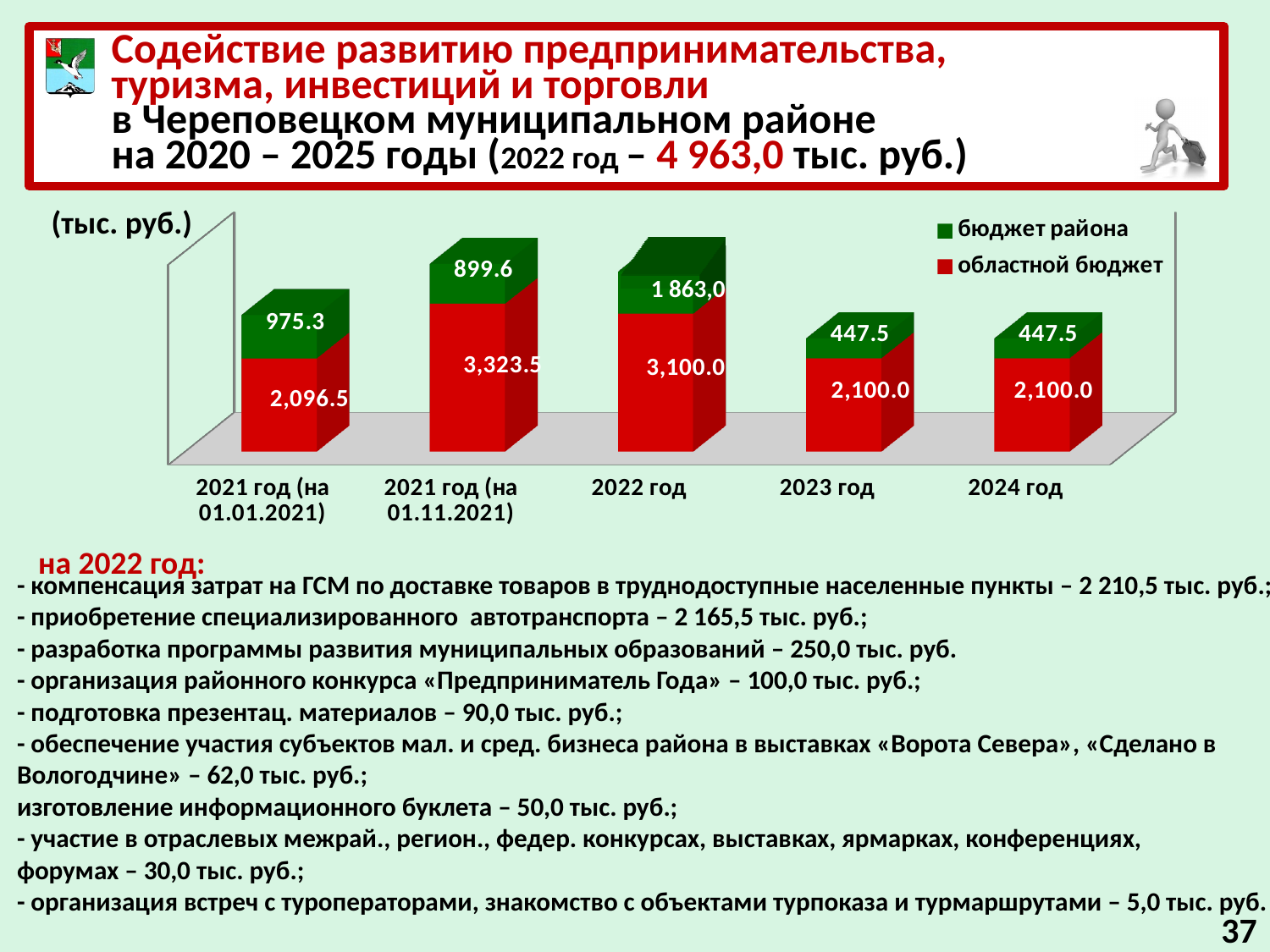
What is the difference between областной бюджет for 2021 год (на 01.11.2021) and 2021 год (на 01.01.2021)? 1,227.0 Which category has the lowest value for областной бюджет? 2021 год (на 01.01.2021) What is the value of бюджет района for 2021 год (на 01.01.2021)? 975.3 What kind of chart is shown on the slide? Stacked bar chart What is the value of бюджет района for 2022 год? 1 863,0 Which category has the highest value for бюджет района? 2022 год How many series does the legend list? 2 How many categories are shown on the x axis? 5 What is the value of областной бюджет for 2021 год (на 01.11.2021)? 3,323.5 What is the total of the stacked bar for 2023 год? 2,547.5 What is the value of областной бюджет for 2022 год? 3,100.0 Which is larger: бюджет района for 2021 год (на 01.01.2021) or for 2021 год (на 01.11.2021)? 2021 год (на 01.01.2021)